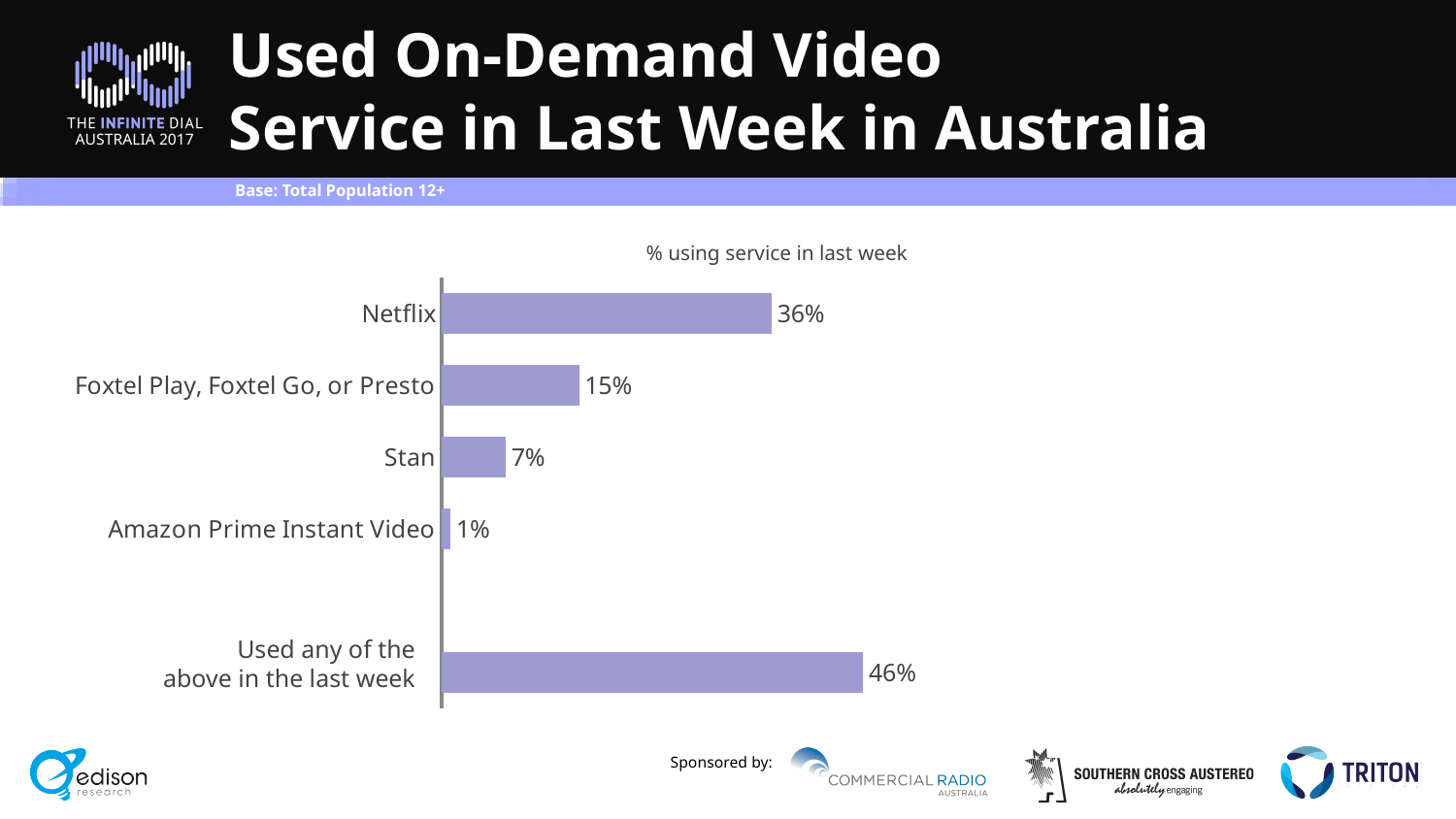
What percentage used any of the listed services in the last week? 46% What percentage used Netflix in the last week? 36% What is the value for Foxtel Play, Foxtel Go, or Presto? 15% What percentage used Stan in the last week? 7% Which service has the lowest percentage of use in the last week? Amazon Prime Instant Video What is the difference between the Netflix value and the Stan value? 29% What is the value for Amazon Prime Instant Video? 1% What is the base population stated on the slide? Total Population 12+ How many bars are shown in the chart? 5 Which is larger, the value for Foxtel Play, Foxtel Go, or Presto or the value for Stan? Foxtel Play, Foxtel Go, or Presto Which individual service has the highest percentage of use in the last week? Netflix What type of chart is shown on the slide? Bar chart